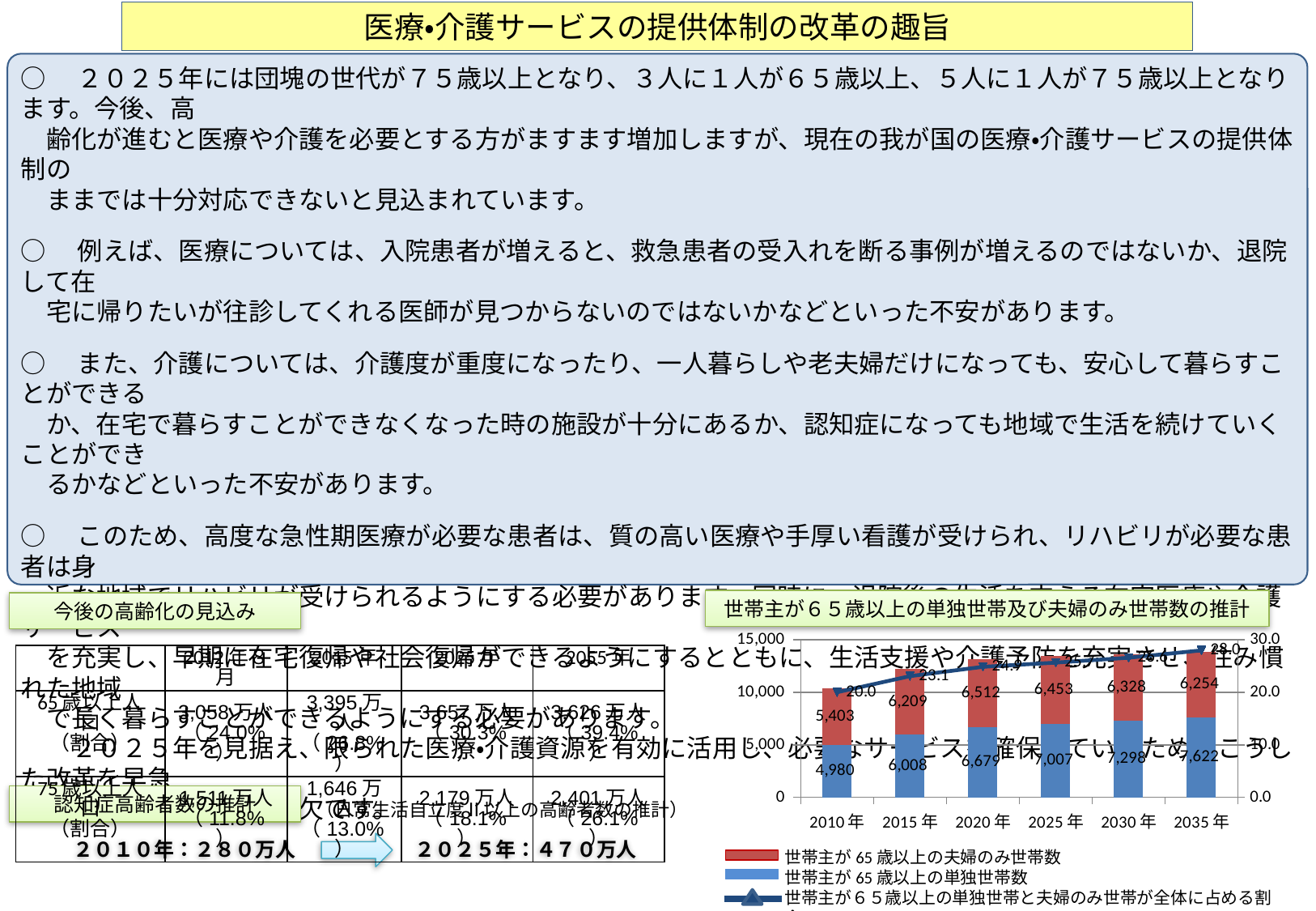
In the chart 世帯主が６５歳以上の単独世帯及び夫婦のみ世帯数の推計, what is the difference between the 単独世帯数 values for 2035年 and 2010年? 2,642 In the chart 世帯主が６５歳以上の単独世帯及び夫婦のみ世帯数の推計, what is the value of 世帯主が65歳以上の単独世帯数 for 2010年? 4,980 In the chart 世帯主が６５歳以上の単独世帯及び夫婦のみ世帯数の推計, does the line for the share of households (割合) rise or fall from 2010年 to 2035年? Rise In the chart 世帯主が６５歳以上の単独世帯及び夫婦のみ世帯数の推計, which is larger for 2030年: 単独世帯数 or 夫婦のみ世帯数? 単独世帯数 How many series does the legend of the chart 世帯主が６５歳以上の単独世帯及び夫婦のみ世帯数の推計 list? 3 In the chart 世帯主が６５歳以上の単独世帯及び夫婦のみ世帯数の推計, which year has the lowest value for 世帯主が65歳以上の夫婦のみ世帯数? 2010年 In the chart 世帯主が６５歳以上の単独世帯及び夫婦のみ世帯数の推計, which year has the highest value for 世帯主が65歳以上の単独世帯数? 2035年 In the chart 世帯主が６５歳以上の単独世帯及び夫婦のみ世帯数の推計, what is the value of 世帯主が65歳以上の単独世帯数 for 2025年? 7,007 How many years are shown on the x axis of the chart 世帯主が６５歳以上の単独世帯及び夫婦のみ世帯数の推計? 6 What kind of chart is shown under the title 世帯主が６５歳以上の単独世帯及び夫婦のみ世帯数の推計? Stacked bar chart with a line In the chart 世帯主が６５歳以上の単独世帯及び夫婦のみ世帯数の推計, what is the value of 世帯主が65歳以上の夫婦のみ世帯数 for 2035年? 6,254 In the chart 世帯主が６５歳以上の単独世帯及び夫婦のみ世帯数の推計, what is the total of the stacked bar for 2020年? 13,191